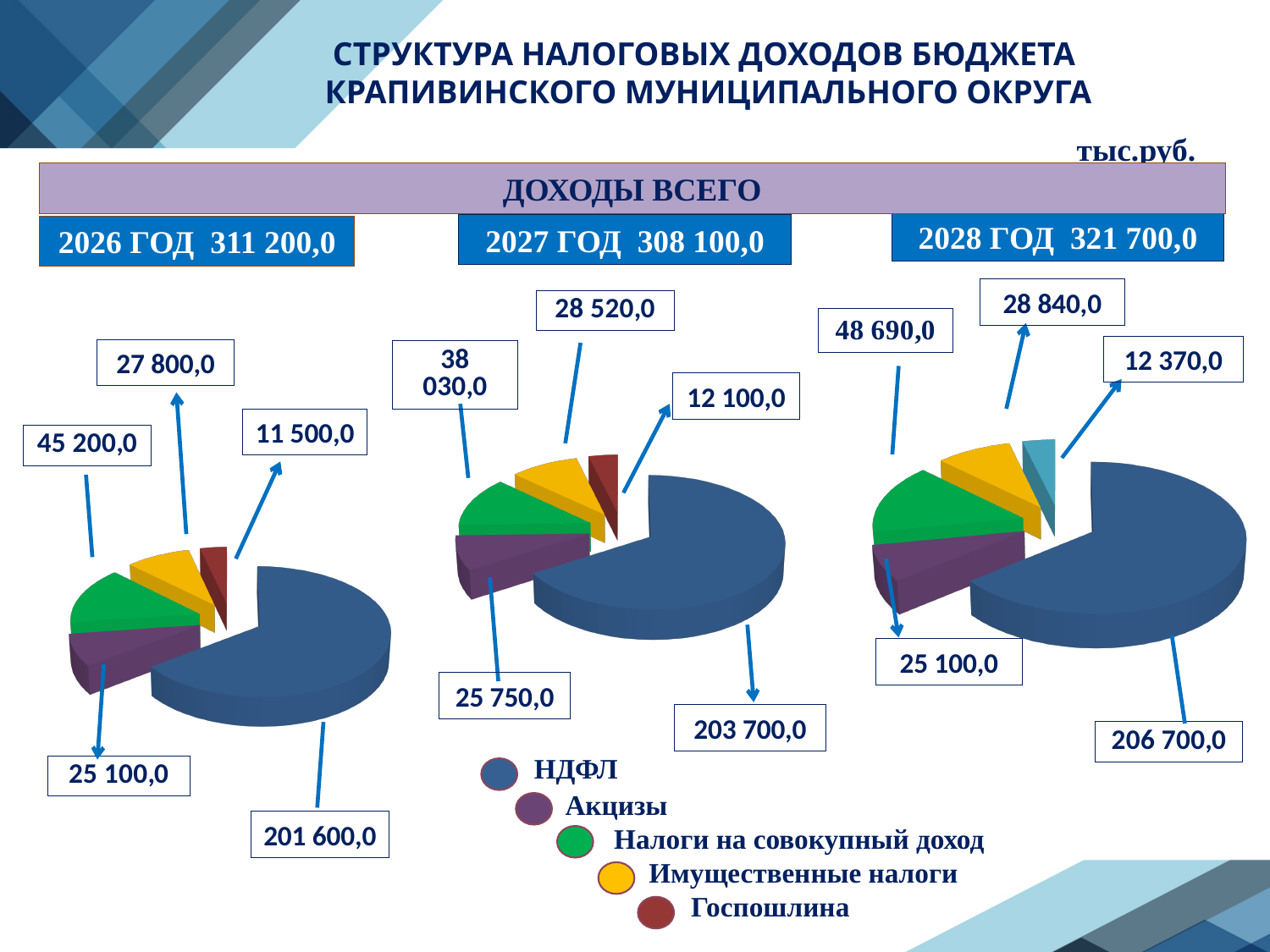
In the 2028 pie chart, what is the value for Имущественные налоги? 28 840,0 What type of chart is used for each year on this slide? Pie chart In the 2027 pie chart, which category has the smallest slice? Госпошлина In the 2026 pie chart, which category has the largest slice? НДФЛ In the 2026 pie chart, what is the difference between Налоги на совокупный доход and Имущественные налоги? 17 400,0 How many categories does the legend list? 5 Which is larger: Акцизы in the 2027 pie chart or Акцизы in the 2026 pie chart? 2027 (25 750,0) In the 2027 pie chart, what is the value for Госпошлина? 12 100,0 In the 2027 pie chart, what is the value for Налоги на совокупный доход? 38 030,0 By how much is the НДФЛ value in the 2028 pie chart larger than in the 2026 pie chart? 5 100,0 In the 2026 pie chart, what is the value for НДФЛ? 201 600,0 How many slices does the 2028 pie chart have? 5